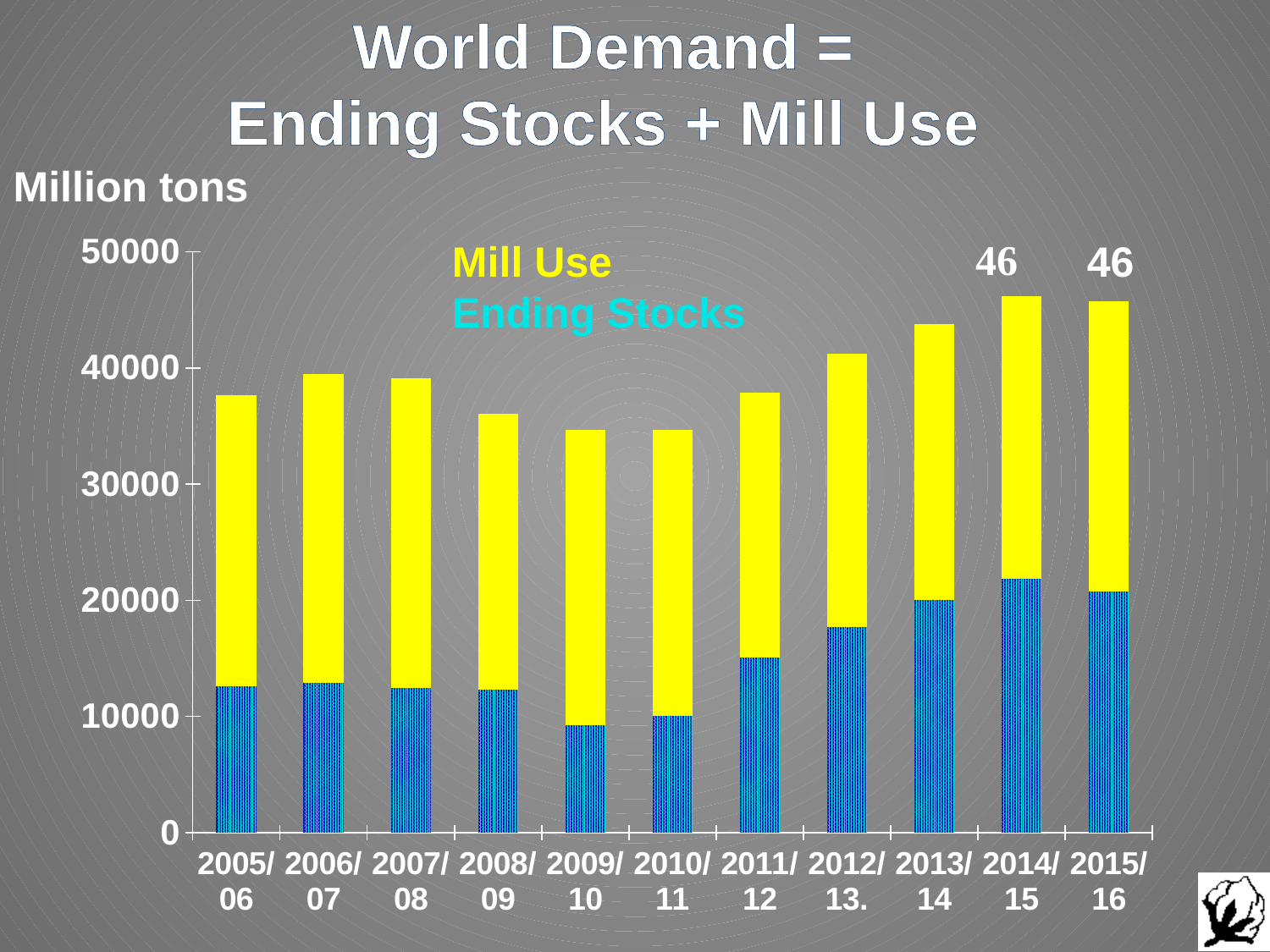
Which has the larger Ending Stocks value, 2012/13 or 2014/15? 2014/15 How many seasons (categories) are shown on the x axis? 11 Do the Ending Stocks values rise or fall from 2009/10 to 2014/15? rise What value is labelled above the bar for 2015/16? 46 Is the Ending Stocks value for 2014/15 greater or less than 20000? greater How many series does the legend list? 2 Is the Ending Stocks value for 2009/10 greater or less than 10000? less Is the total bar height for 2013/14 greater or less than 40000? greater Which colour represents Mill Use in the chart? yellow What kind of chart is shown on the slide? bar chart What value is labelled above the bar for 2014/15? 46